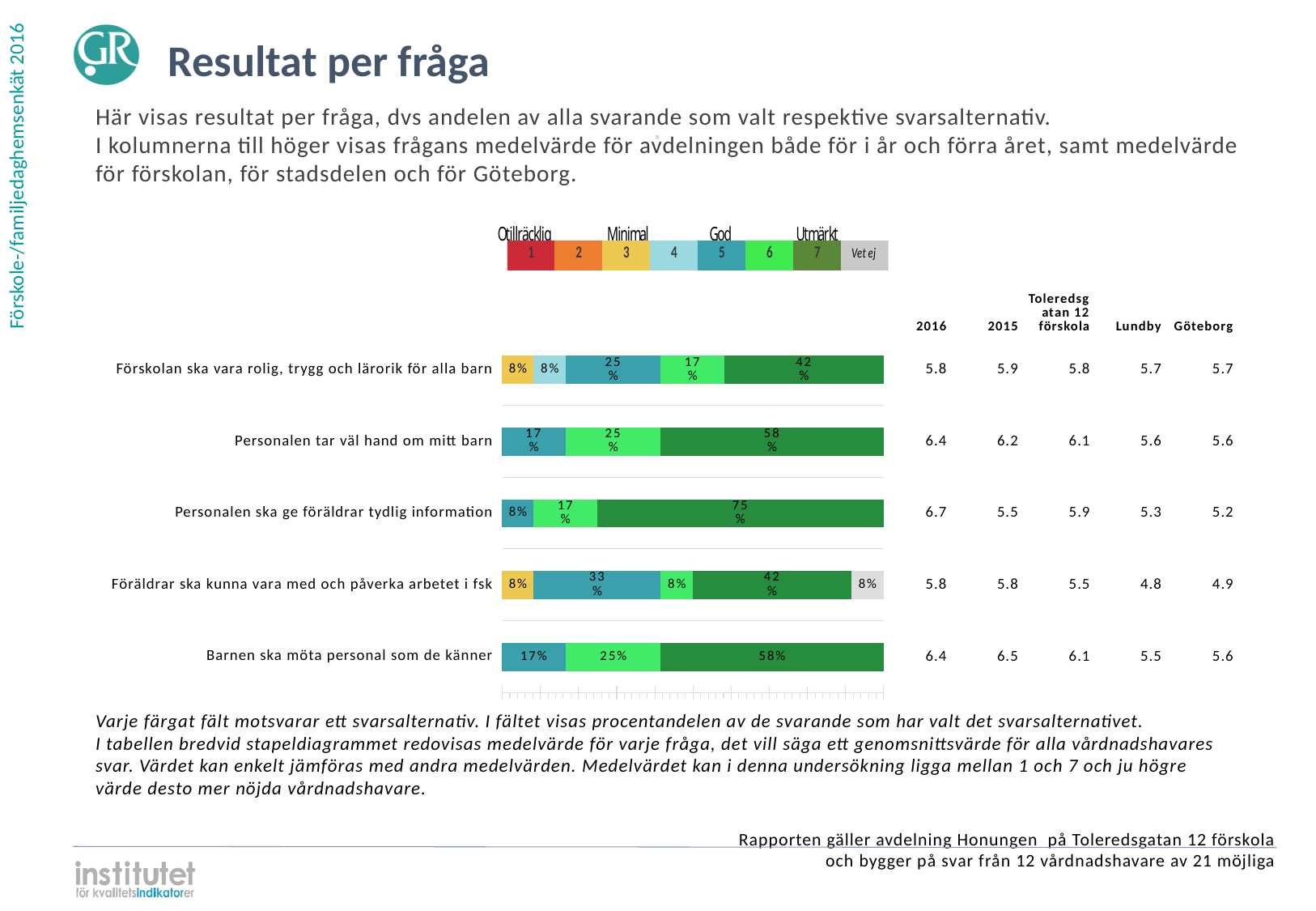
What is the difference in the share choosing 7 between 'Personalen tar väl hand om mitt barn' and 'Förskolan ska vara rolig, trygg och lärorik för alla barn'? 16 percentage points What percentage of respondents answered 'Vet ej' for 'Föräldrar ska kunna vara med och påverka arbetet i fsk'? 8% What is the total of the labelled segments in the bar for 'Personalen tar väl hand om mitt barn'? 100% Which has a larger share choosing 6: 'Personalen tar väl hand om mitt barn' or 'Förskolan ska vara rolig, trygg och lärorik för alla barn'? Personalen tar väl hand om mitt barn What percentage of respondents chose 7 (Utmärkt) for 'Personalen ska ge föräldrar tydlig information'? 75% How many entries does the colour legend above the chart list? 8 What percentage of respondents chose 5 for 'Föräldrar ska kunna vara med och påverka arbetet i fsk'? 33% Which question has the largest share of respondents choosing 7 (Utmärkt)? Personalen ska ge föräldrar tydlig information What label does the legend give to the answer value 7? Utmärkt How many labelled segments does the bar for 'Förskolan ska vara rolig, trygg och lärorik för alla barn' have? 5 How many questions (categories) are plotted in the bar chart? 5 What kind of chart is shown on the slide? Stacked bar chart